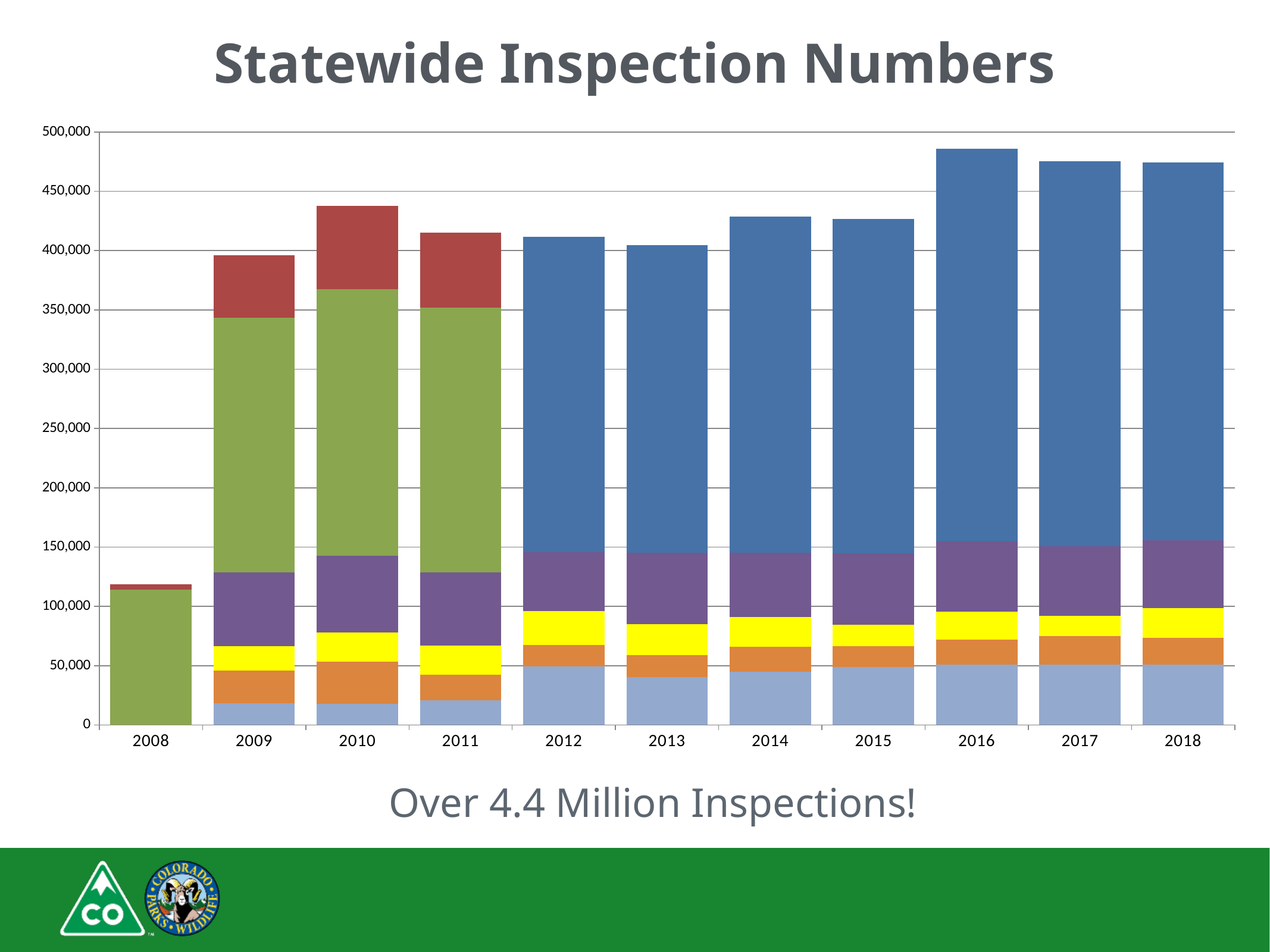
Which year has the shortest stacked bar in the chart? 2008 Is the total bar height for 2013 greater or less than 350,000? greater How many years are shown along the x axis of the chart? 11 Which year has the tallest stacked bar in the chart? 2016 Is the total bar height for 2016 greater or less than 450,000? greater What is the title of the chart on the slide? Statewide Inspection Numbers What kind of chart is shown on the slide? Stacked bar chart Is the total bar height for 2010 greater or less than 450,000? less Which year has the larger total bar, 2016 or 2013? 2016 Overall, do the total bar heights rise or fall from 2008 to 2018? Rise Which year has the larger total bar, 2010 or 2009? 2010